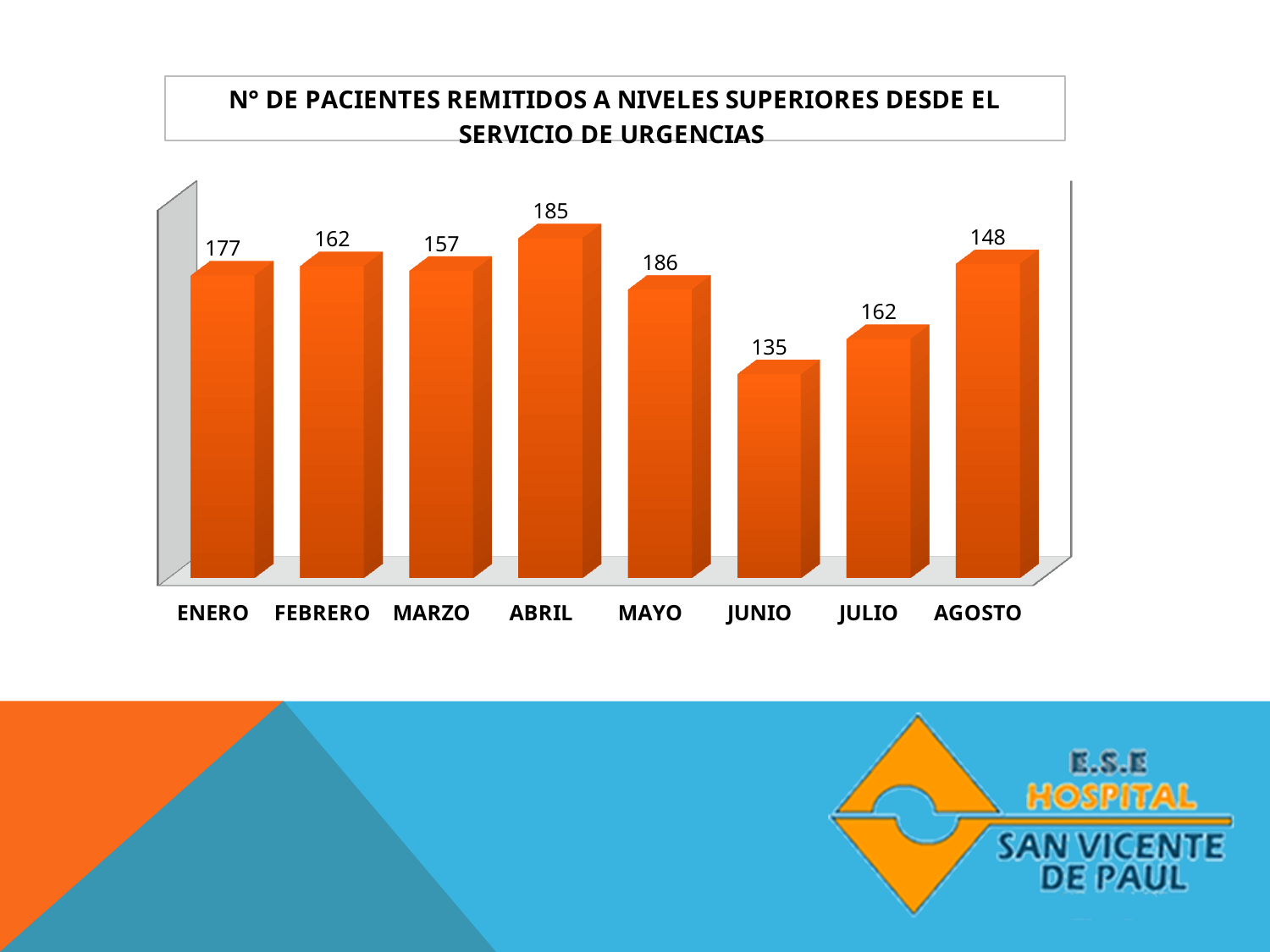
What is the value for AGOSTO? 148 How many months are shown on the x axis? 8 What is the difference between the values for JULIO and AGOSTO? 14 What is the difference between the values for ABRIL and JUNIO? 50 Which is larger, the value for AGOSTO or the value for JULIO? JULIO What is the value for ENERO? 177 Which is larger, the value for MARZO or the value for JUNIO? MARZO What colour are the bars in the chart? orange What kind of chart is shown on the slide? bar chart Which month has the lowest value? JUNIO What is the value for JUNIO? 135 What is the value for ABRIL? 185